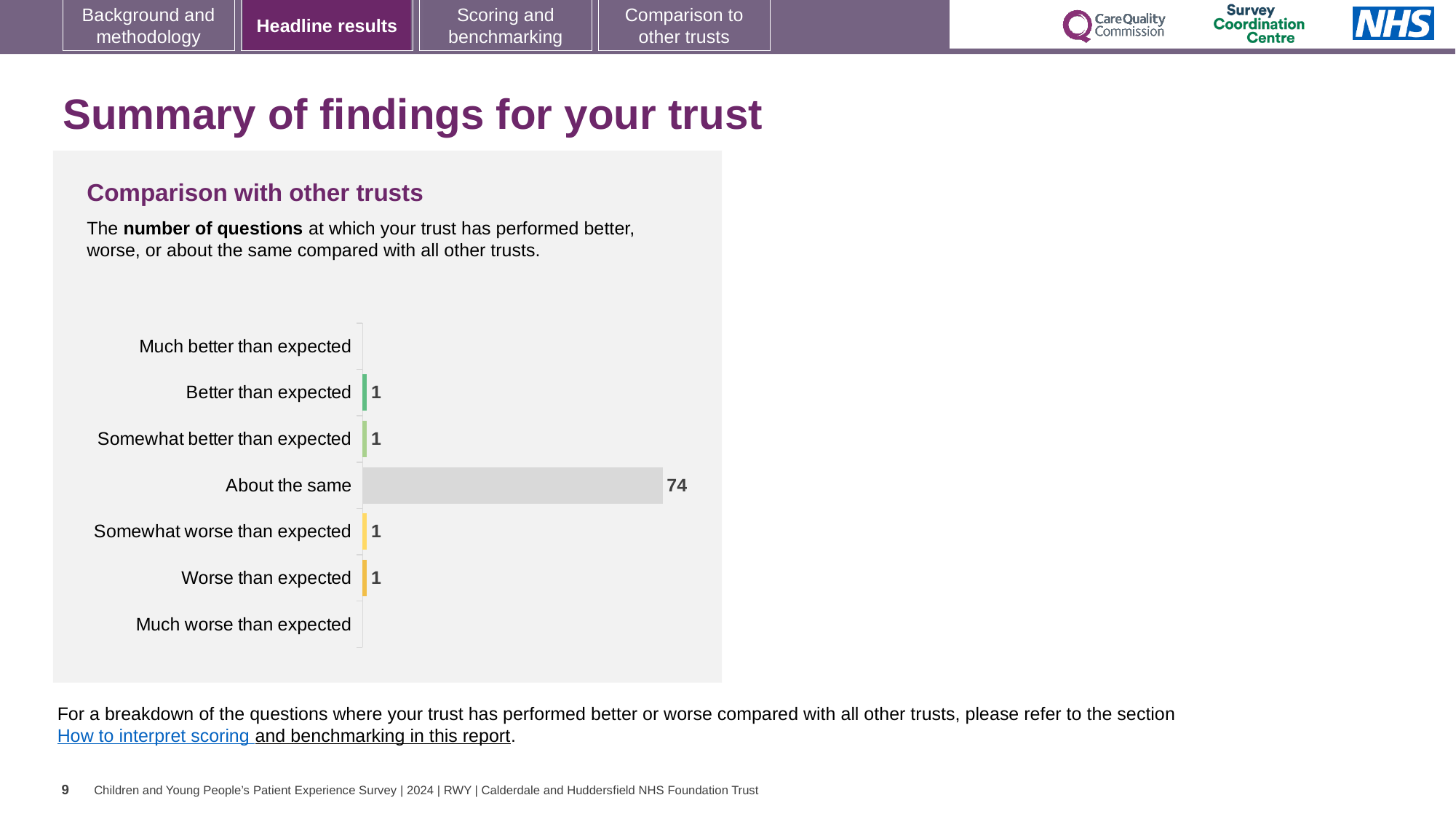
What is the total of the values for 'Better than expected' and 'Somewhat better than expected'? 2 Which is larger: the value for 'About the same' or the value for 'Worse than expected'? About the same How many categories are shown on the chart? 7 What is the value for 'Somewhat worse than expected'? 1 Which category has the highest number of questions? About the same What is the value for 'Worse than expected'? 1 What kind of chart is shown on the slide? Bar chart What is the title of the chart? Comparison with other trusts What is the difference between the number of questions 'About the same' and 'Somewhat better than expected'? 73 How many questions were rated 'About the same'? 74 What is the value for 'Better than expected'? 1 What colour is the bar for 'About the same'? Grey